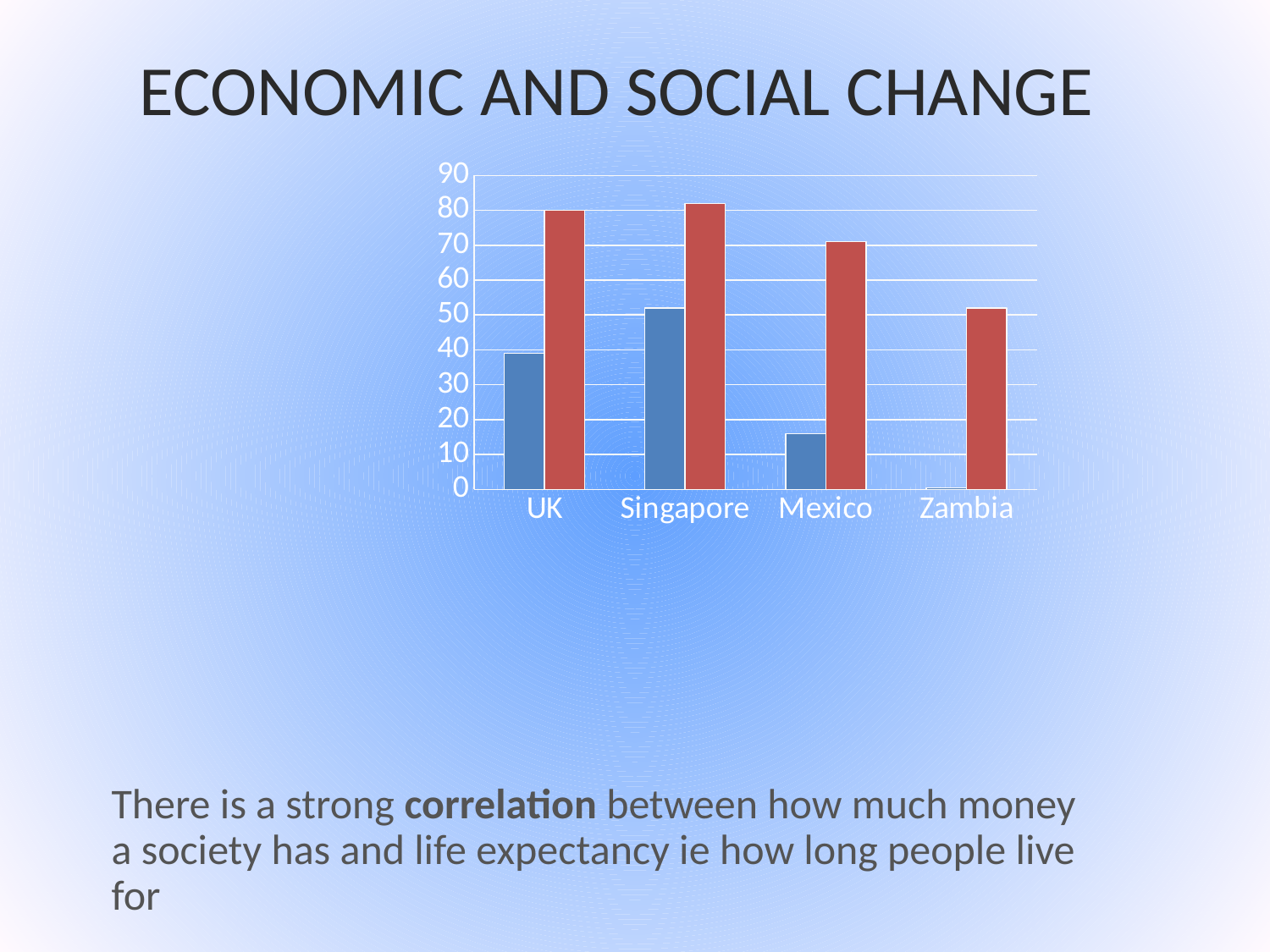
For Mexico, which bar is taller, the blue bar or the red bar? the red bar Which country has the tallest blue bar? Singapore Which country has the shortest blue bar? Zambia What is the highest value shown on the chart's vertical axis? 90 Do the red bars rise or fall from Singapore to Zambia along the x axis? fall Is the red bar for Zambia greater or less than 40? greater What kind of chart is shown on the slide? bar chart How many countries are shown on the x axis of the chart? 4 Is the red bar for the UK greater or less than 70? greater Is the blue bar for the UK greater or less than 50? less Which country has the shortest red bar? Zambia